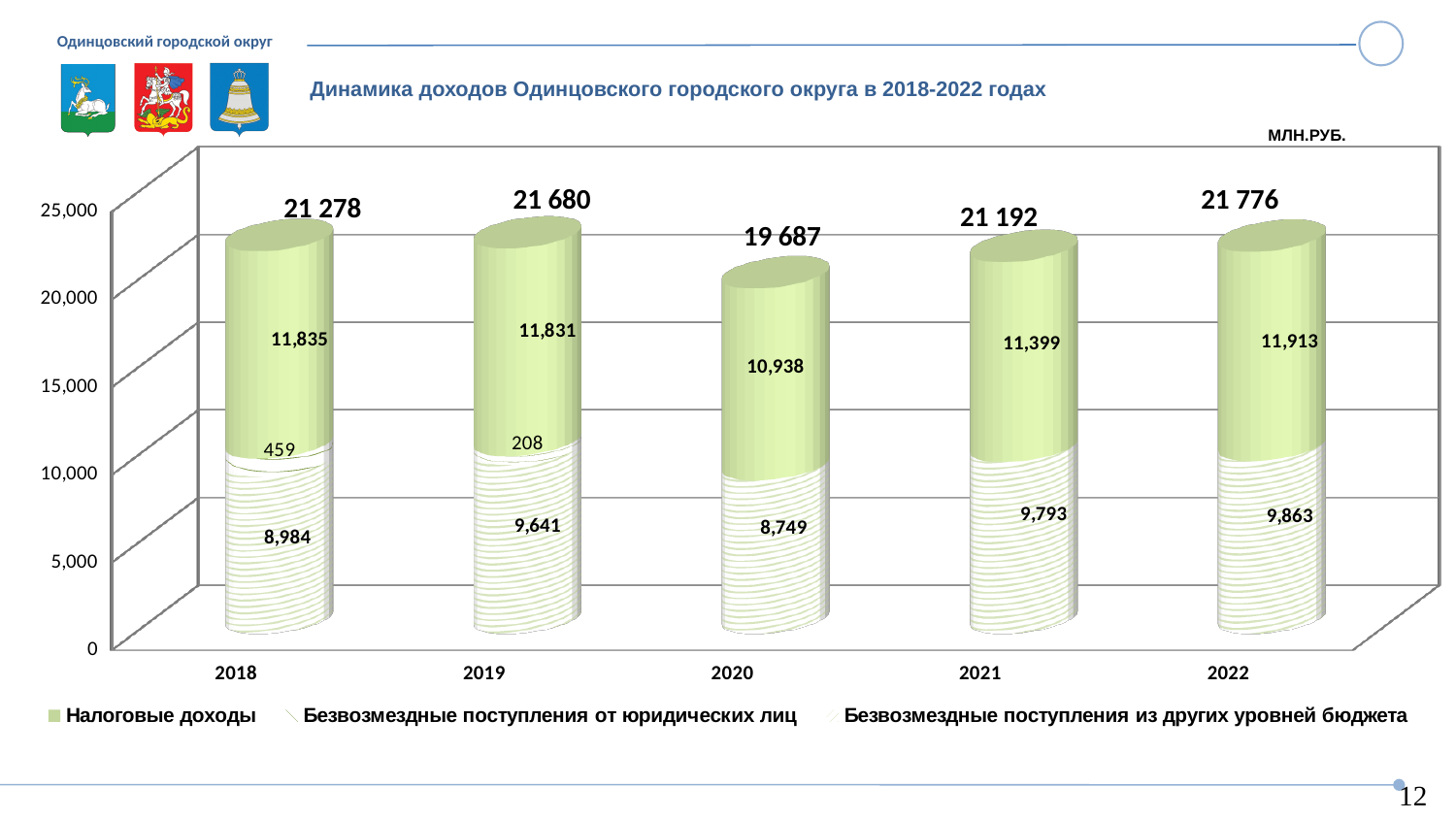
By how much did Налоговые доходы in 2022 exceed Налоговые доходы in 2021? 514 What is the total revenue shown above the bar for 2018? 21 278 How many series does the chart legend list? 3 How many years are shown on the x axis of the chart? 5 In what units are the values on the chart expressed? млн.руб. Which year has the lowest total revenue? 2020 Which year has the highest total revenue? 2022 What is the value of Налоговые доходы in 2022? 11,913 Which year has the larger value of Налоговые доходы, 2020 or 2021? 2021 What is the value of Налоговые доходы in 2020? 10,938 What kind of chart is shown on the slide? Bar chart What is the total revenue shown above the bar for 2020? 19 687